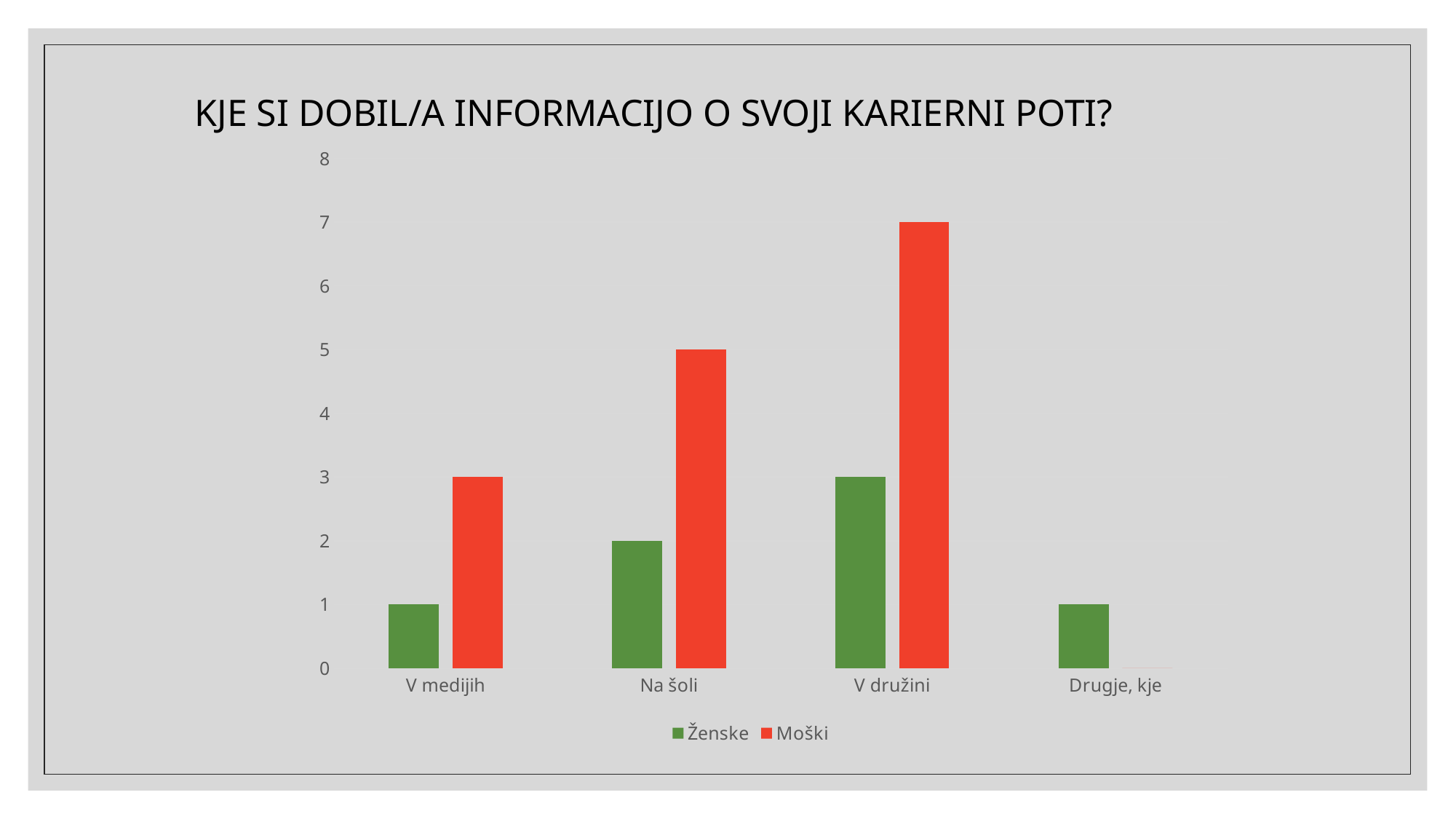
What is the value for Ženske in the Na šoli category? 2 How many categories are shown on the x axis? 4 What type of chart is shown on the slide? bar chart In the V družini category, which series has the larger value, Ženske or Moški? Moški In which category is the Moški value highest? V družini In which category is the Moški value lowest? Drugje, kje What is the value for Moški in the V medijih category? 3 Is the value for Moški in the Na šoli category greater or less than 4? greater What is the title of the chart? KJE SI DOBIL/A INFORMACIJO O SVOJI KARIERNI POTI? What is the value for Moški in the V družini category? 7 How many series does the legend list? 2 What is the difference between the Moški and Ženske values in the Na šoli category? 3